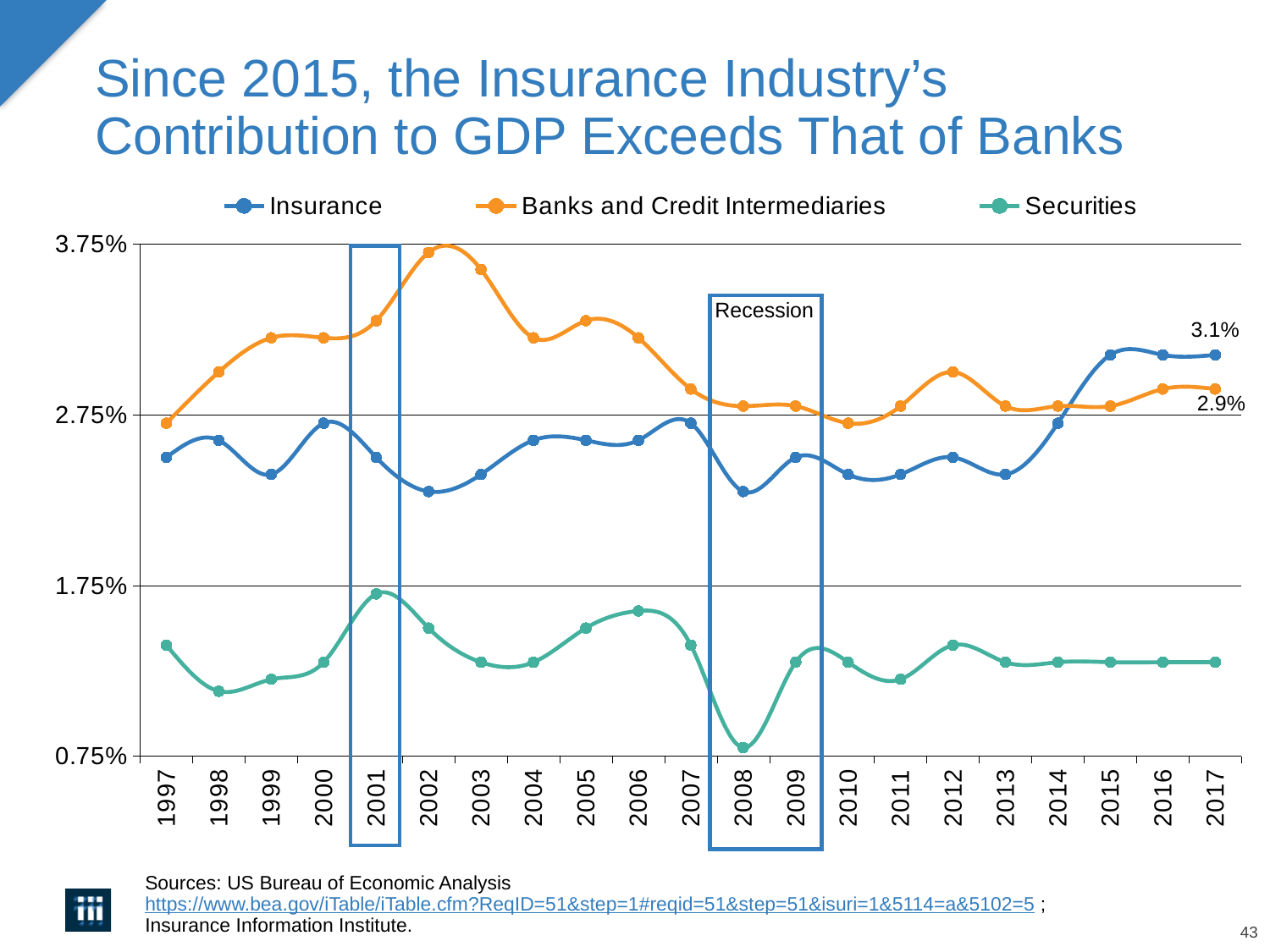
What is the Insurance value for 2017? 3.1% In which year is the Securities series at its lowest? 2008 Is the Securities value for 2008 greater or less than 1.75%? less In 2017, which is larger: Insurance or Banks and Credit Intermediaries? Insurance In which year is the Banks and Credit Intermediaries series at its highest? 2002 What is the Banks and Credit Intermediaries value for 2017? 2.9% Is the Banks and Credit Intermediaries value for 2002 greater or less than 2.75%? greater What kind of chart is shown on the slide? line chart How many series does the legend list? 3 What is the difference between the Insurance and Banks and Credit Intermediaries values in 2017? 0.2% What label is written inside the box highlighting 2008 and 2009? Recession How many years are plotted along the x axis? 21